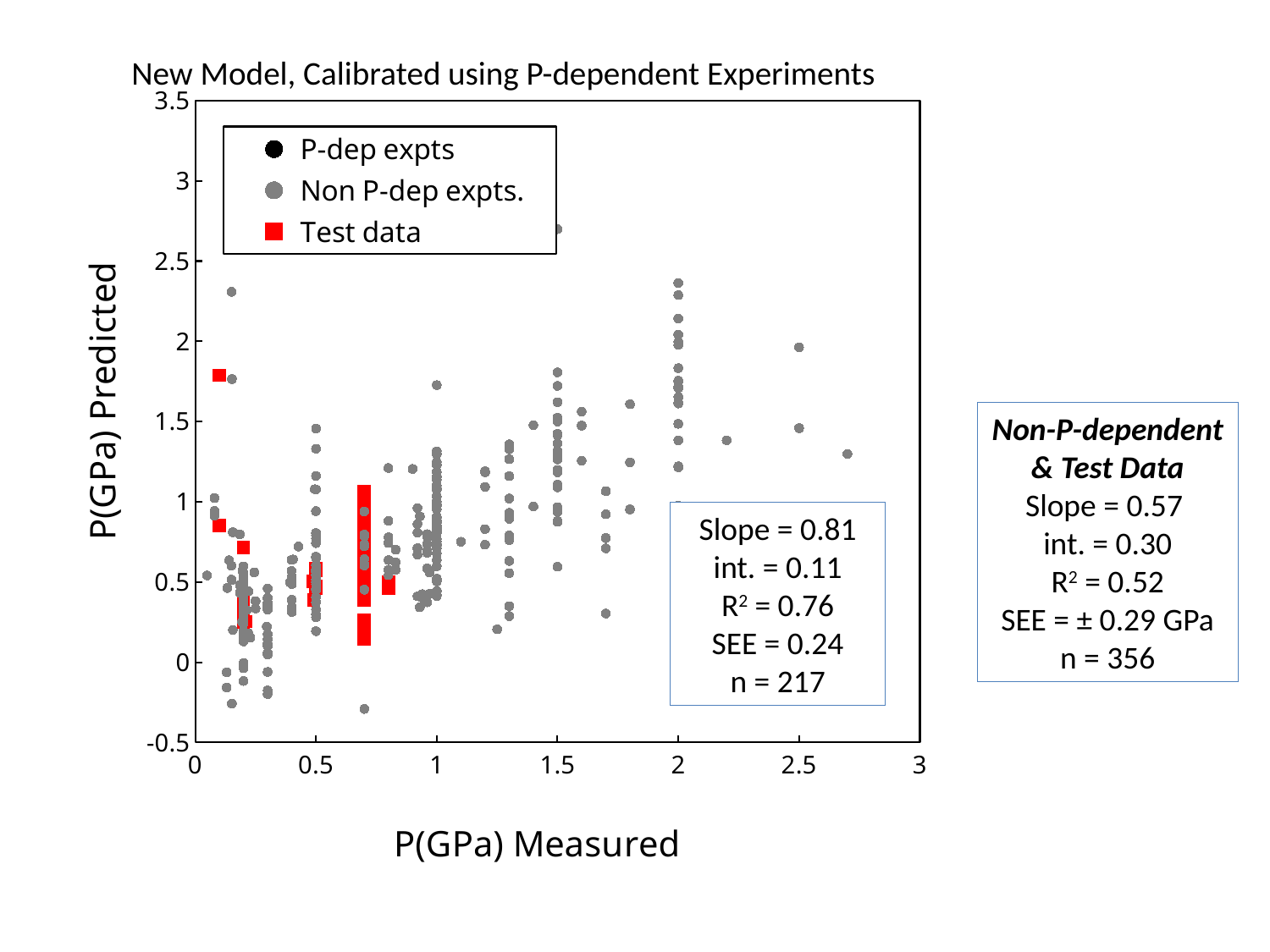
What is n in the 'Non-P-dependent & Test Data' box? 356 What kind of chart is shown on the slide? Scatter chart Overall, do the predicted pressures tend to rise or fall as the measured pressure increases along the x axis? rise What is the slope reported in the text box inside the chart? 0.81 How many series does the chart legend list? 3 What is the SEE reported in the 'Non-P-dependent & Test Data' box? ± 0.29 GPa What is the title of the chart? New Model, Calibrated using P-dependent Experiments Is the predicted value for the point at a measured pressure of 2.7 GPa greater or less than 1.5? less Is the highest predicted value at a measured pressure of 1.5 GPa greater or less than 2.5? greater Which legend entry is shown with red square markers? Test data What is the R² value reported in the text box inside the chart? 0.76 What is n in the text box inside the chart? 217